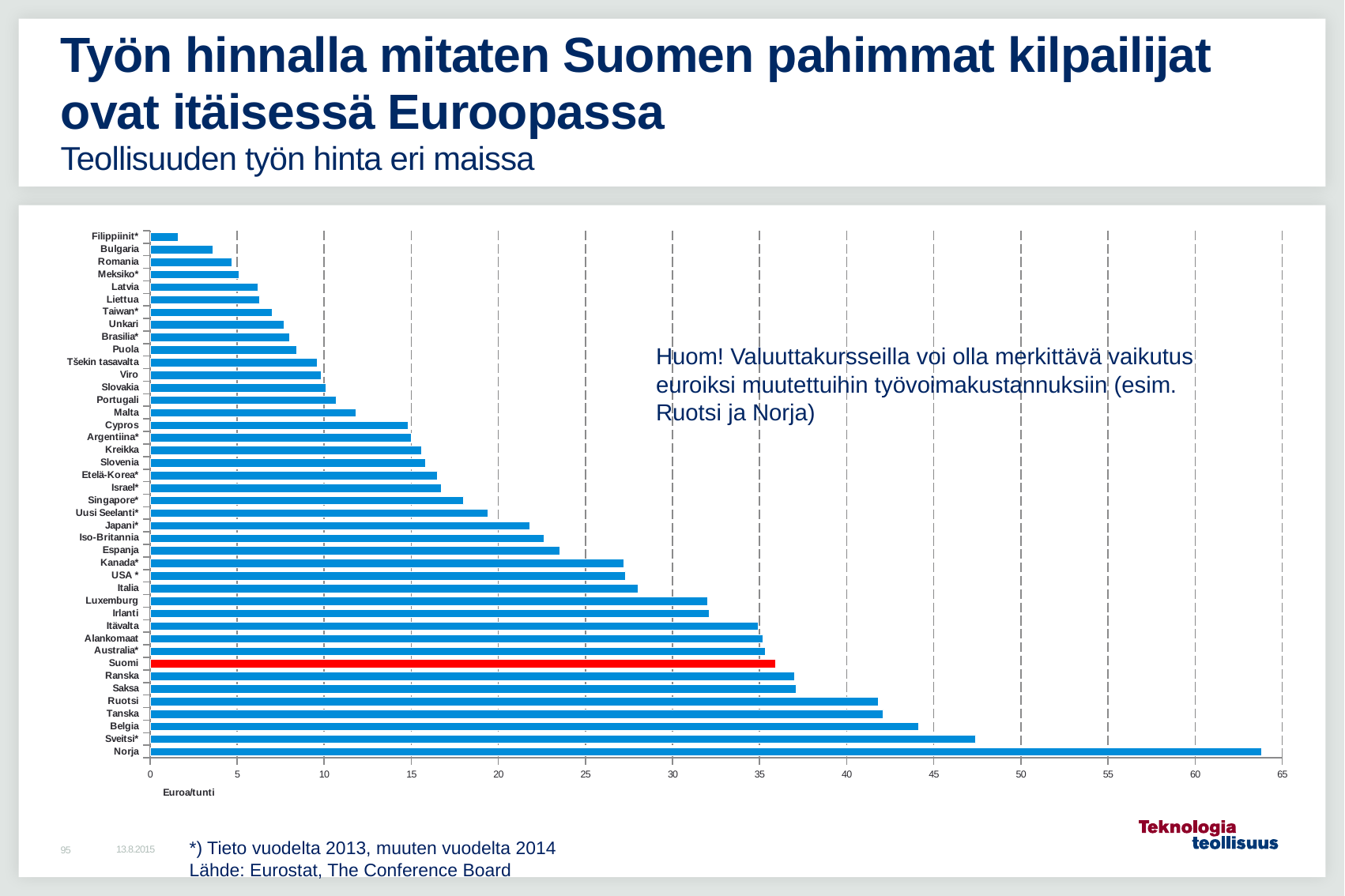
Which country has the lowest value in the chart? Filippiinit* How many countries are listed in the chart? 42 Which has a larger value, Italia or Espanja? Italia What kind of chart is shown on the slide? bar chart Which has a larger value, Ruotsi or Suomi? Ruotsi Is the value for Suomi greater or less than 40? less Is the value for Sveitsi* greater or less than 45? greater Is the value for Puola greater or less than 10? less Which country's bar is highlighted in red? Suomi Which country has the highest value in the chart? Norja